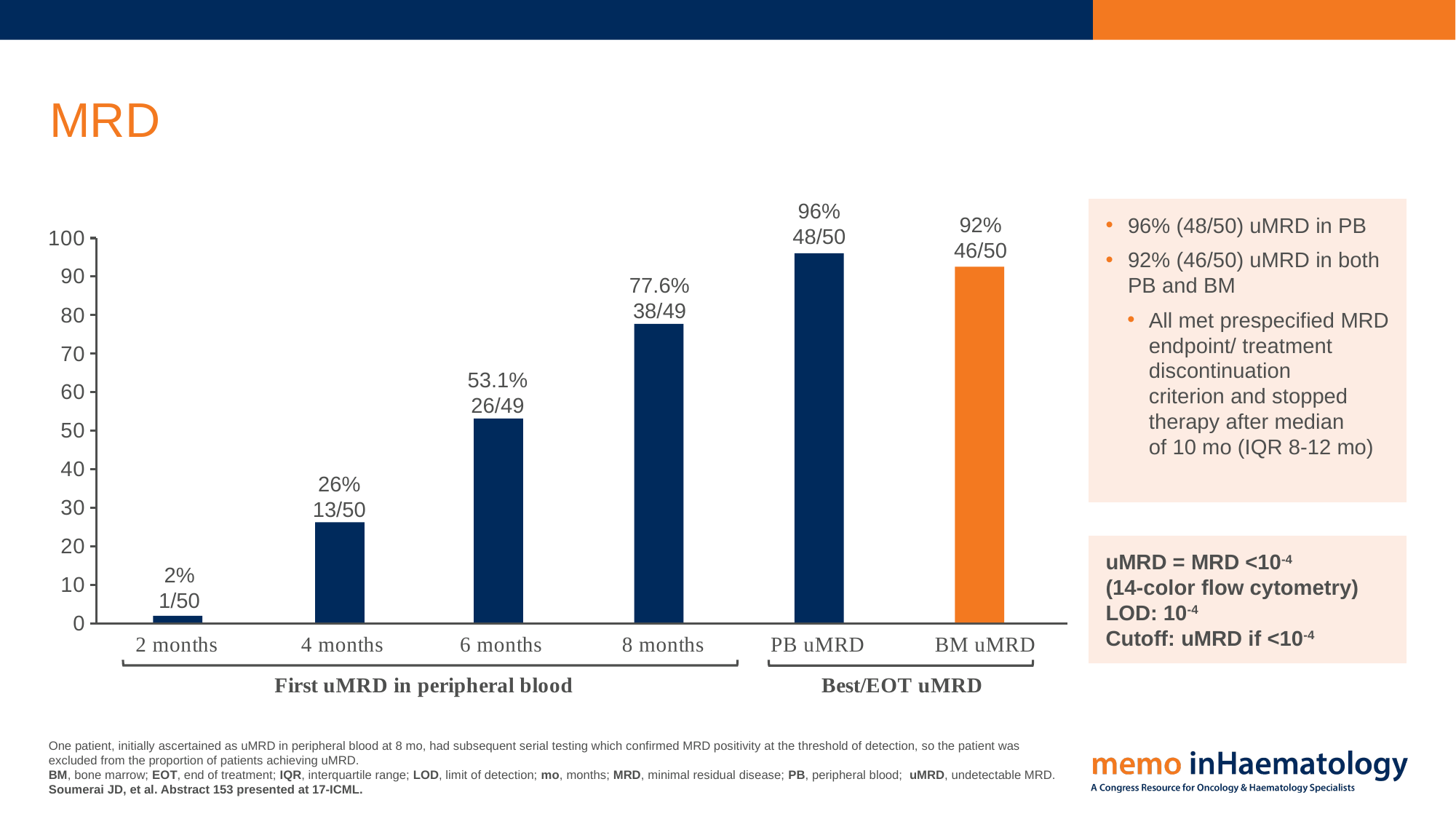
How many bars are plotted in the chart? 6 What fraction of patients is labelled on the 4 months bar? 13/50 Which category has the highest bar? PB uMRD What is the difference in percentage points between the 8 months bar and the 6 months bar? 24.5 What type of chart is shown on the slide? Bar chart What fraction is labelled on the PB uMRD bar? 48/50 Which is larger, the value for 4 months or the value for 6 months? 6 months Is the value for 8 months greater or less than 70? greater Which category has the lowest bar? 2 months What percentage is shown for BM uMRD? 92% Do the values rise or fall from 2 months to 8 months? Rise What percentage is shown for the 6 months bar? 53.1%